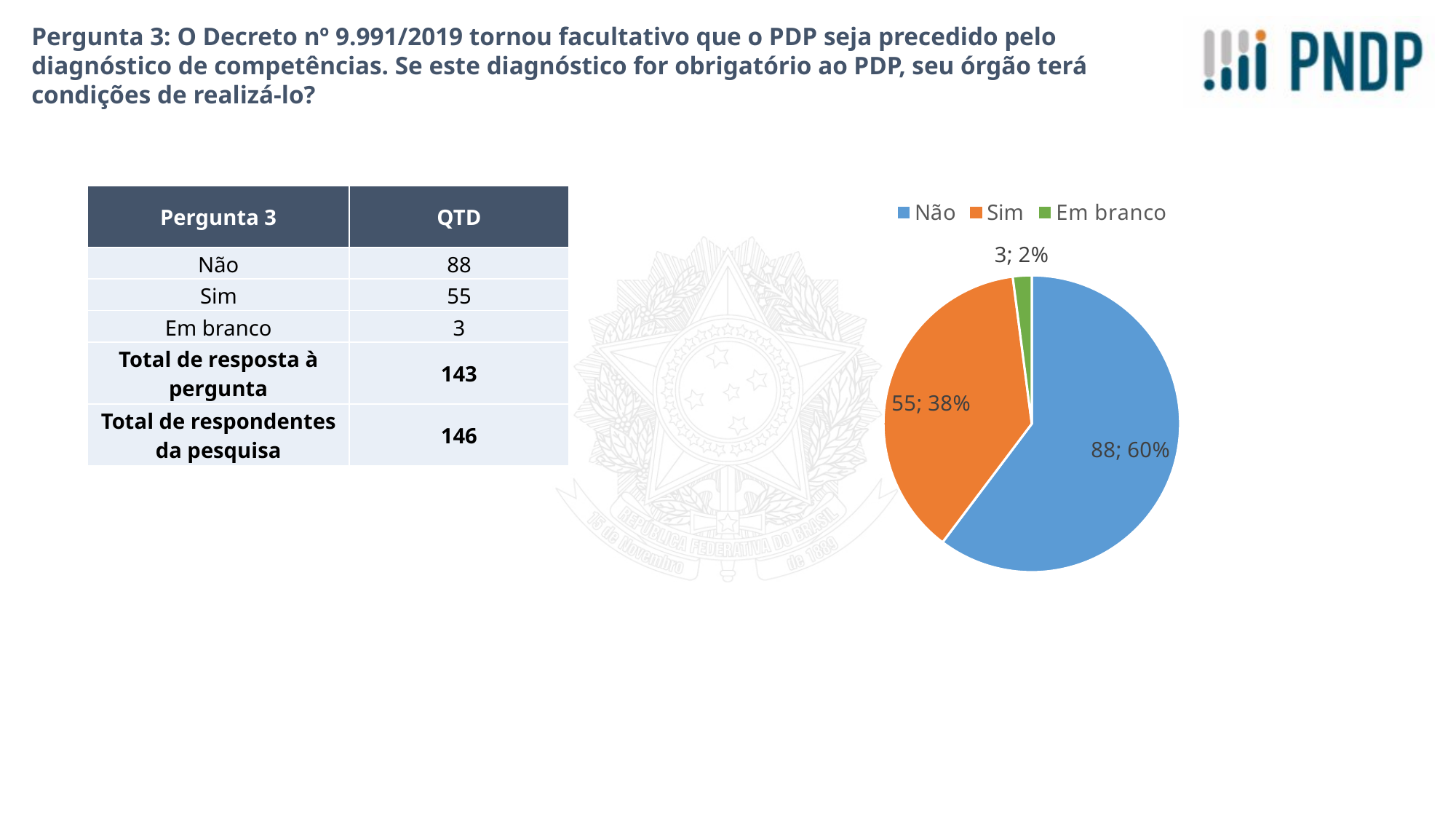
How many slices does the pie chart have? 3 How many entries does the legend of the pie chart list? 3 What is the count shown for the Sim slice of the pie chart? 55 Which category has the largest slice in the pie chart? Não What is the count shown for the Não slice of the pie chart? 88 What is the difference between the counts for Não and Sim in the pie chart? 33 What is the count shown for the Em branco slice of the pie chart? 3 Which colour represents Sim in the pie chart? orange What kind of chart is shown on the slide? pie chart What percentage share does the Sim slice have in the pie chart? 38% Which category has the smallest slice in the pie chart? Em branco What percentage share does the Não slice have in the pie chart? 60%